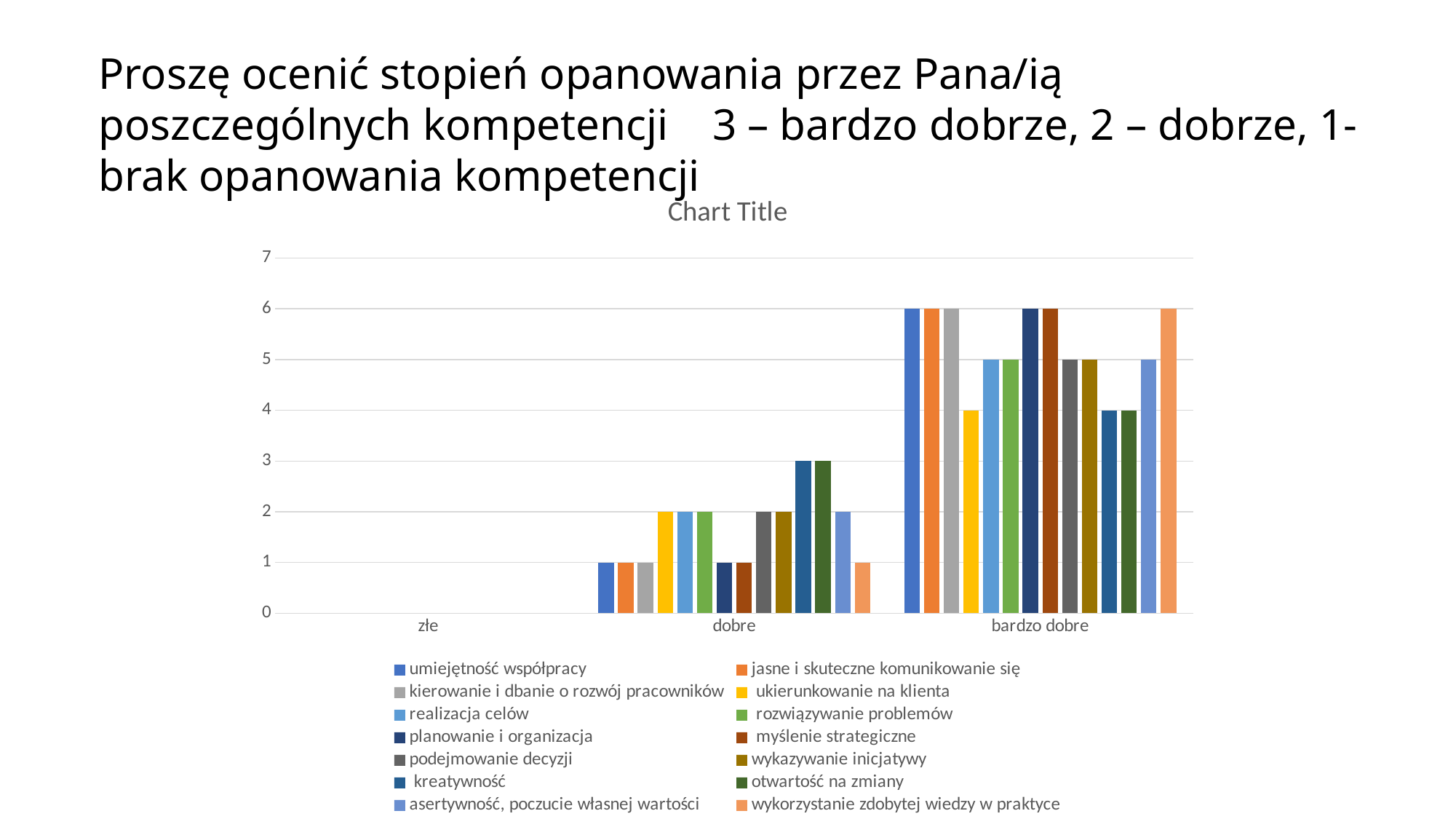
Is the value for 'planowanie i organizacja' in the 'bardzo dobre' category greater or less than 5? greater What is the value for 'kreatywność' in the 'dobre' category? 3 What is the difference between the 'bardzo dobre' and 'dobre' values for 'umiejętność współpracy'? 5 What kind of chart is shown on the slide? bar chart How many categories are shown on the x axis of the chart? 3 What is the value for 'realizacja celów' in the 'dobre' category? 2 What is the value for 'umiejętność współpracy' in the 'bardzo dobre' category? 6 How many series does the chart's legend list? 14 Which is larger: the 'bardzo dobre' value for 'realizacja celów' or the 'bardzo dobre' value for 'kreatywność'? realizacja celów What is the title shown above the chart? Chart Title Which series has the highest value in the 'dobre' category? kreatywność and otwartość na zmiany What is the value for 'ukierunkowanie na klienta' in the 'bardzo dobre' category? 4